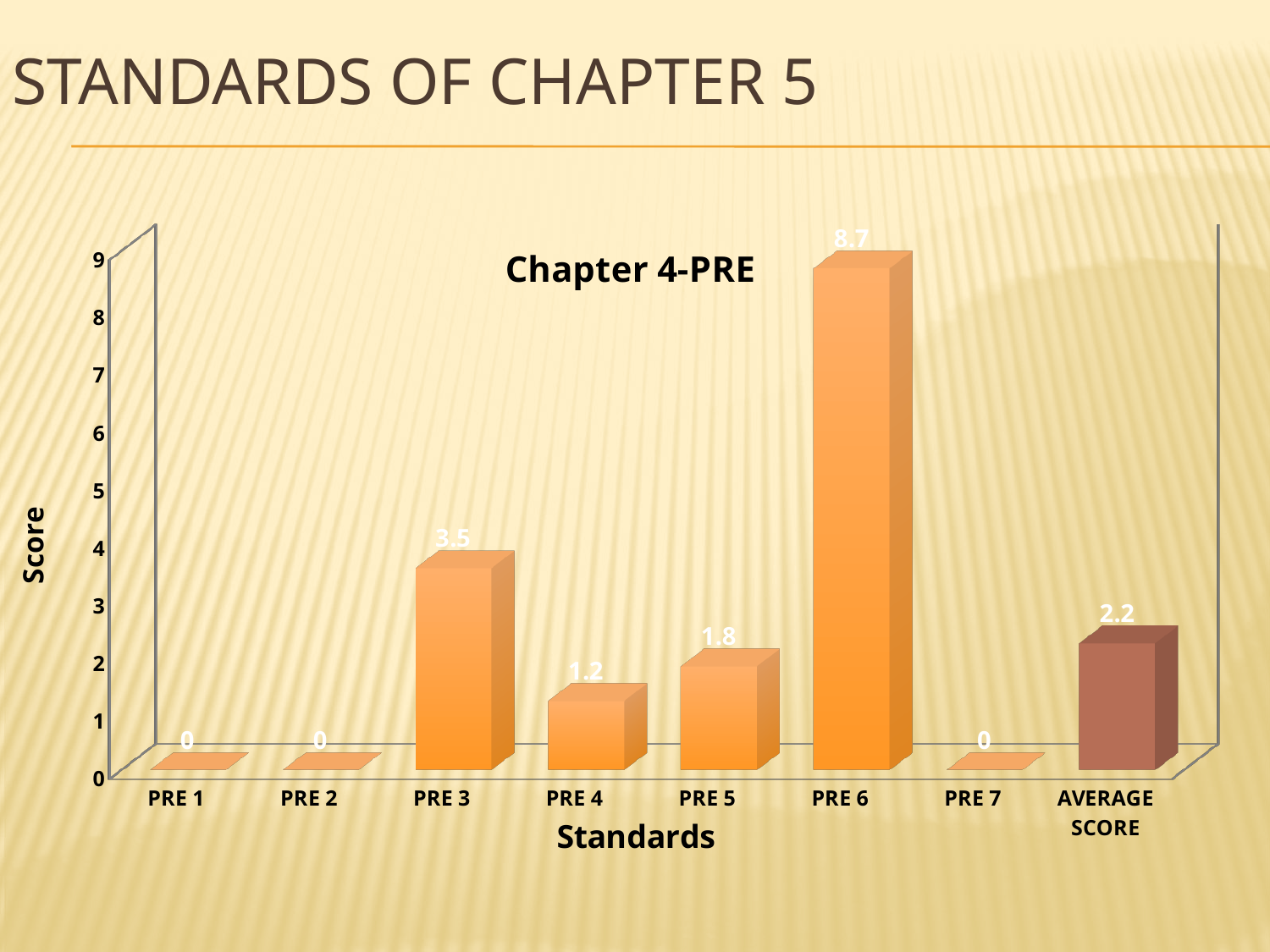
What is the score for PRE 3? 3.5 How many categories are shown on the x axis? 8 What is the score for PRE 6? 8.7 What is the value shown for AVERAGE SCORE? 2.2 What is the difference between the scores for PRE 6 and PRE 3? 5.2 How many standards have a score of 0? 3 Which standard has the highest score? PRE 6 Which is larger, the score for PRE 5 or the score for PRE 4? PRE 5 What is the difference between the scores for PRE 5 and PRE 4? 0.6 What kind of chart is shown on the slide? Bar chart What is the score for PRE 4? 1.2 What is the title of the chart? Chapter 4-PRE